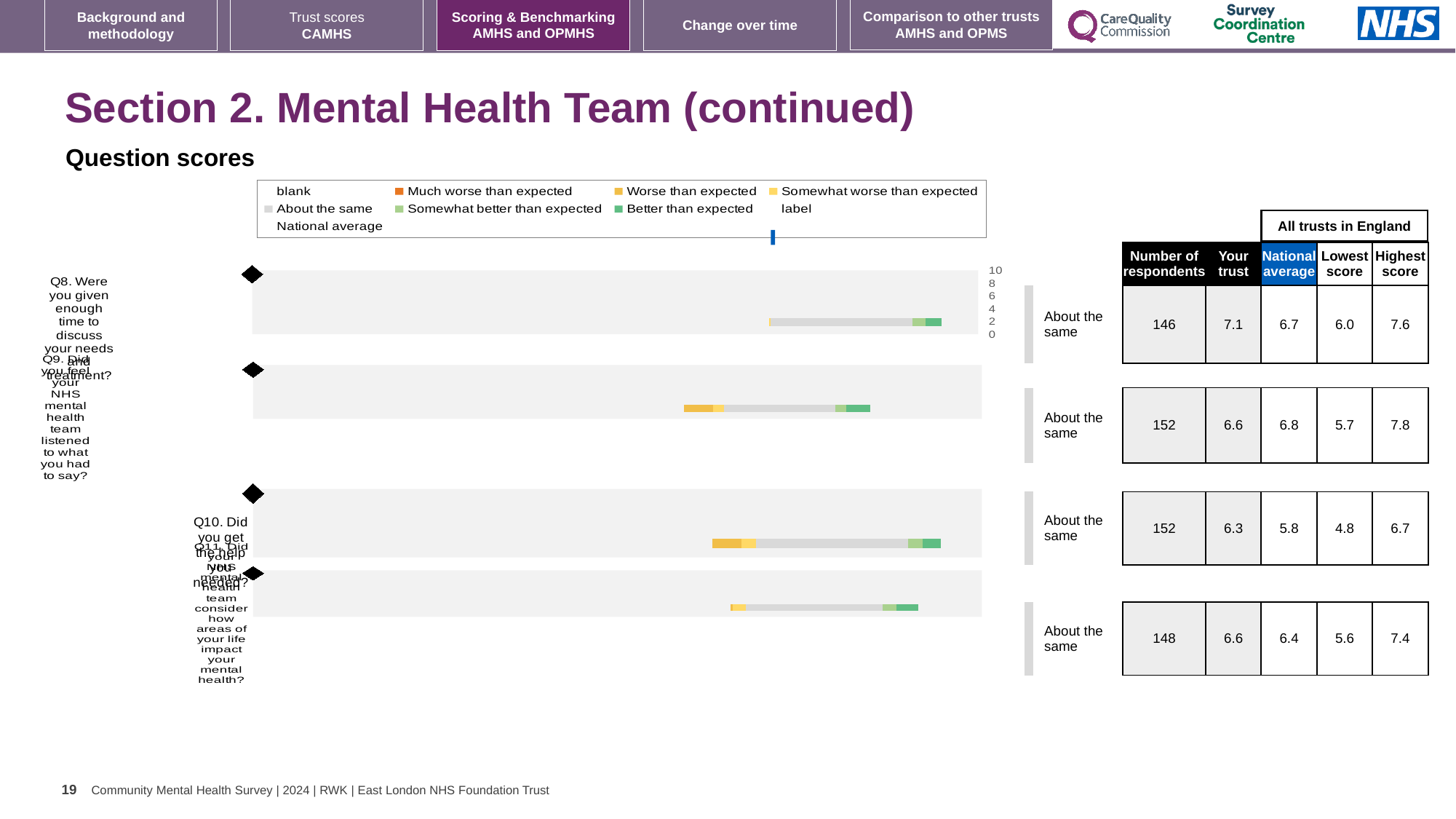
What is the 'Your trust' score for Q8 (Were you given enough time to discuss your needs and treatment?)? 7.1 How many respondents answered Q10 (Did you get the help you needed?)? 152 What is the lowest score across all trusts in England for Q11? 5.6 Which question has the highest 'Your trust' score? Q8 How many questions (Q8 to Q11) are plotted in the question scores chart? 4 What is the difference between the highest score (7.6) and the lowest score (6.0) across all trusts in England for Q8? 1.6 What benchmark category is shown for Q10 in the question scores chart? About the same What is the national average score for Q9 (Did you feel your NHS mental health team listened to what you had to say?)? 6.8 Which question has the lowest 'Your trust' score? Q10 What colour does the legend use for 'Better than expected'? Green What kind of chart is used to show the question scores on this slide? bar chart For Q9, which is larger: the 'Your trust' score or the national average? National average